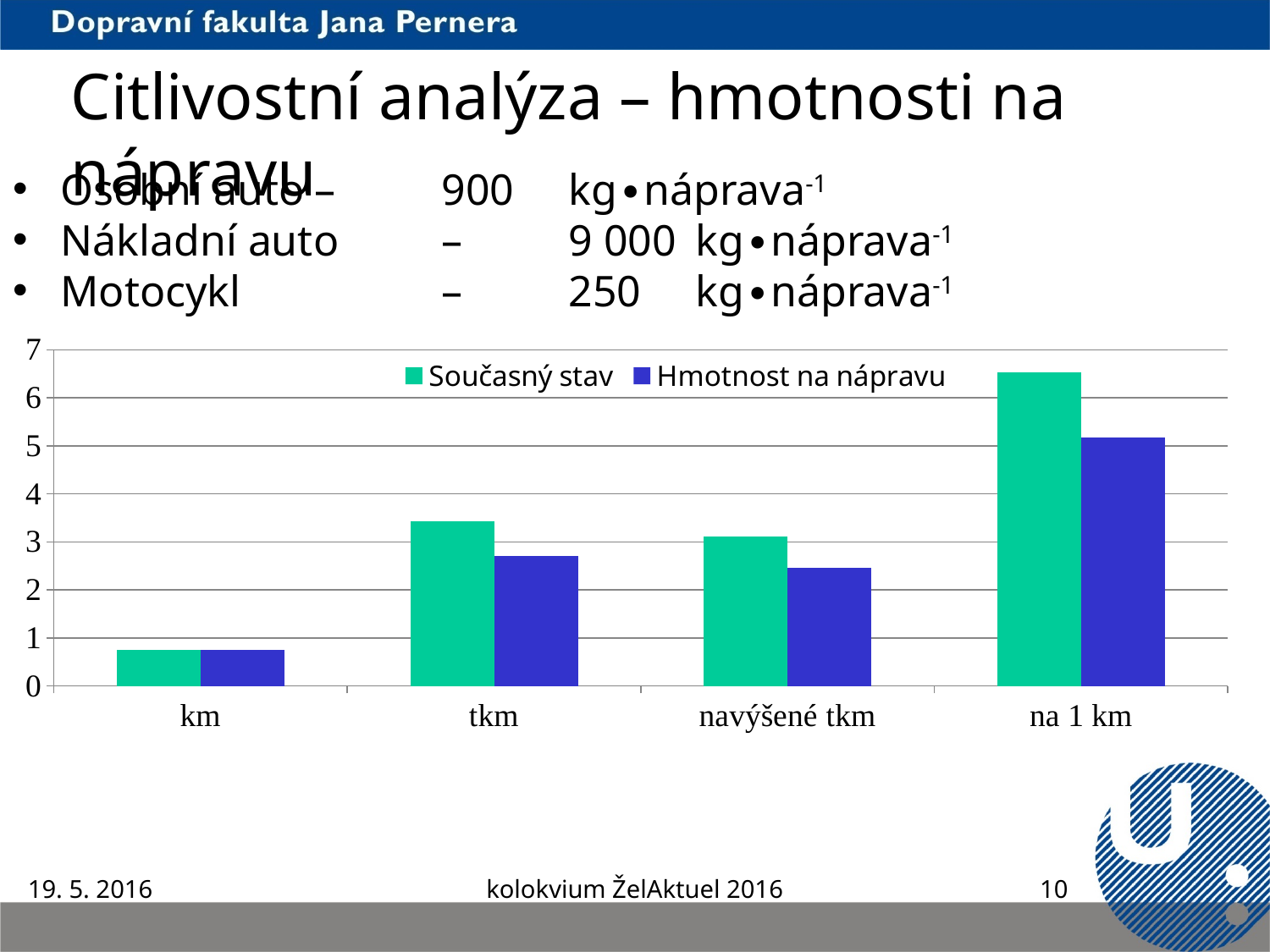
What are the two series names listed in the chart legend? Současný stav and Hmotnost na nápravu Is the value for Hmotnost na nápravu in the na 1 km category greater or less than 5? greater Is the value for Současný stav in the km category greater or less than 1? less Which category has the highest value for Současný stav? na 1 km Which category has the lowest value for Hmotnost na nápravu? km How many series does the chart legend list? 2 What kind of chart is shown on the slide? bar chart Is the value for Hmotnost na nápravu in the tkm category greater or less than 3? less For Hmotnost na nápravu, which is larger, the value for tkm or the value for navýšené tkm? tkm In the tkm category, which series has the larger value, Současný stav or Hmotnost na nápravu? Současný stav How many categories are shown on the x axis of the chart? 4